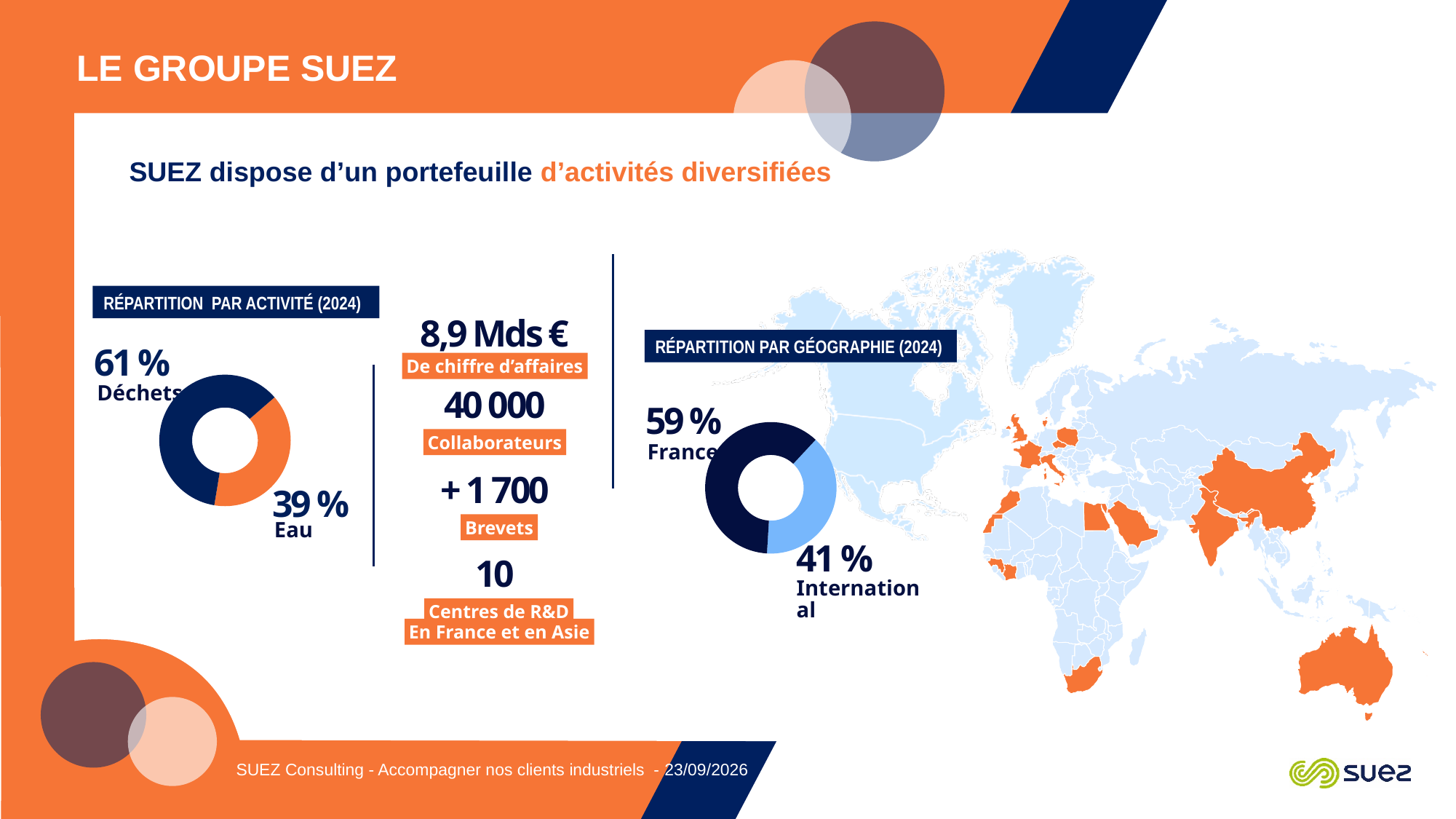
What kind of chart is used for 'RÉPARTITION PAR ACTIVITÉ (2024)'? Donut (pie) chart In the 'RÉPARTITION PAR ACTIVITÉ (2024)' chart, what share is Eau? 39 % In the 'RÉPARTITION PAR ACTIVITÉ (2024)' chart, what is the difference in percentage points between Déchets and Eau? 22 percentage points In the 'RÉPARTITION PAR ACTIVITÉ (2024)' chart, what colour is the Eau segment? Orange In the 'RÉPARTITION PAR GÉOGRAPHIE (2024)' chart, what share is France? 59 % In the 'RÉPARTITION PAR ACTIVITÉ (2024)' chart, how many categories are shown? 2 In the 'RÉPARTITION PAR GÉOGRAPHIE (2024)' chart, is the share for France larger or smaller than the share for International? Larger In the 'RÉPARTITION PAR ACTIVITÉ (2024)' chart, what share is Déchets? 61 % In the 'RÉPARTITION PAR GÉOGRAPHIE (2024)' chart, what share is International? 41 % In the 'RÉPARTITION PAR ACTIVITÉ (2024)' chart, which category has the largest share? Déchets In the 'RÉPARTITION PAR GÉOGRAPHIE (2024)' chart, what is the difference in percentage points between France and International? 18 percentage points In the 'RÉPARTITION PAR GÉOGRAPHIE (2024)' chart, which category has the smallest share? International